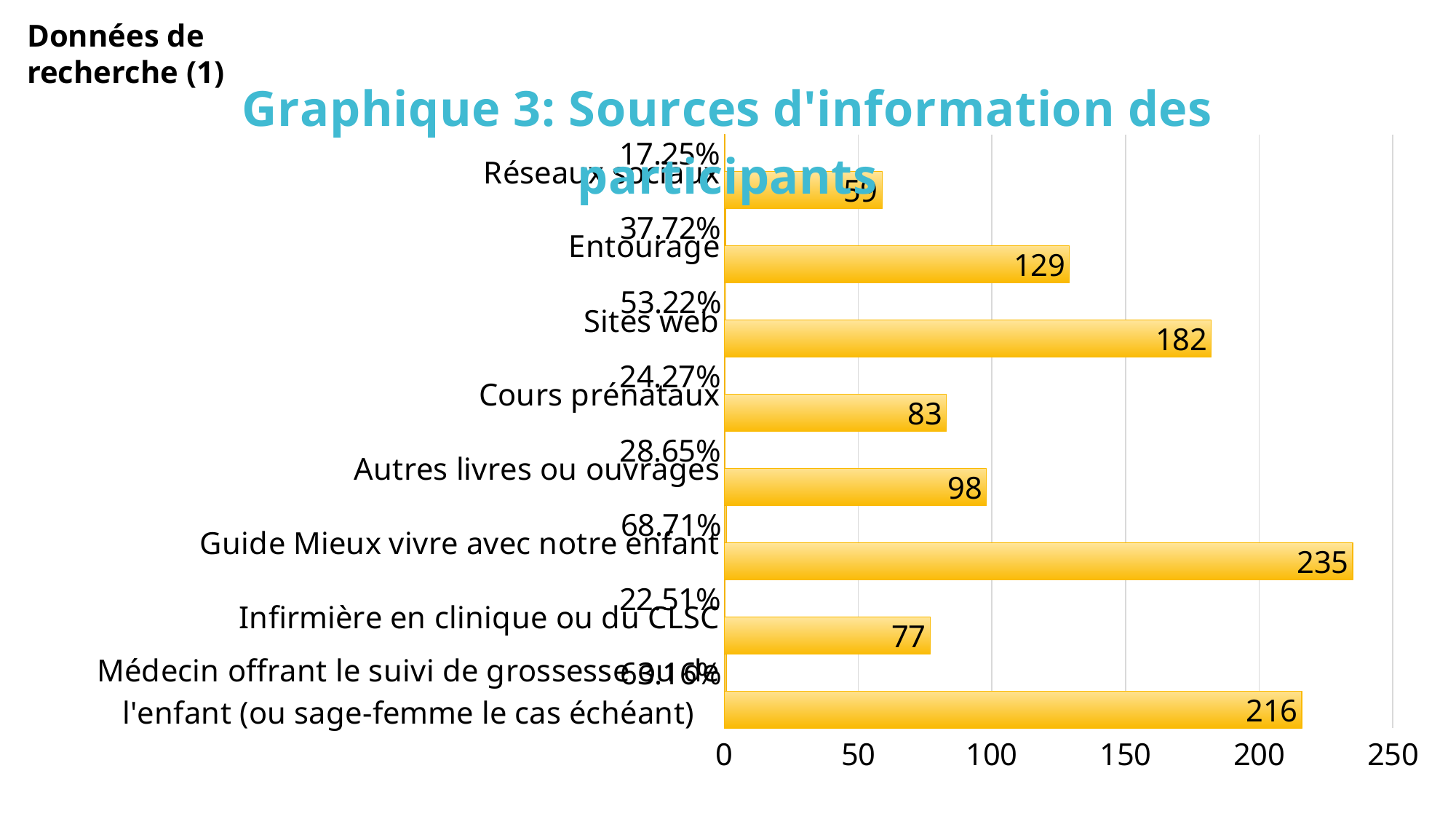
What is the value for Infirmière en clinique ou du CLSC? 77 What is the value for Sites web? 182 What kind of chart is shown on the slide? bar chart Is the value for Entourage greater or less than 100? greater Which category has the highest value? Guide Mieux vivre avec notre enfant How many categories are shown in the chart? 8 Which is larger, the value for Cours prénataux or the value for Autres livres ou ouvrages? Autres livres ou ouvrages What is the difference between the values for Guide Mieux vivre avec notre enfant and Sites web? 53 What percentage is shown for Entourage? 37.72% Which category has the lowest value? Réseaux sociaux What is the value for Guide Mieux vivre avec notre enfant? 235 What is the title of the chart? Graphique 3: Sources d'information des participants